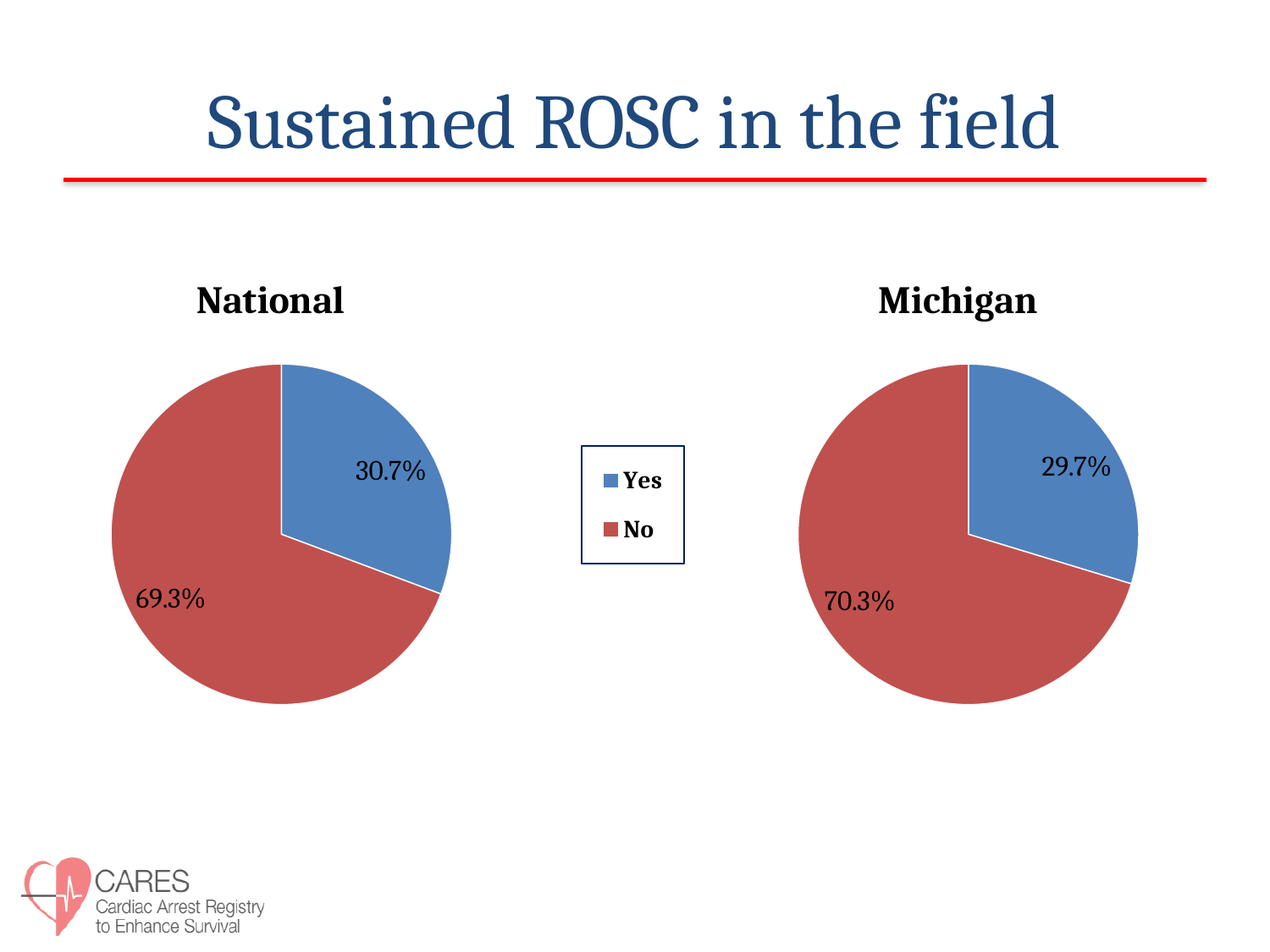
In the Michigan chart, which slice is the smallest? Yes How many entries does the shared legend list? 2 What is the difference between the No share in the Michigan chart and the No share in the National chart? 1.0% In the National chart, what share of the pie is labelled Yes? 30.7% In the Michigan chart, what share of the pie is labelled No? 70.3% Is the Yes share larger in the National chart or the Michigan chart? National How many slices does the Michigan chart have? 2 What colour represents No in the legend? Red In the Michigan chart, what share of the pie is labelled Yes? 29.7% In the National chart, which slice is the largest? No In the National chart, what share of the pie is labelled No? 69.3% What type of chart is the National chart? Pie chart